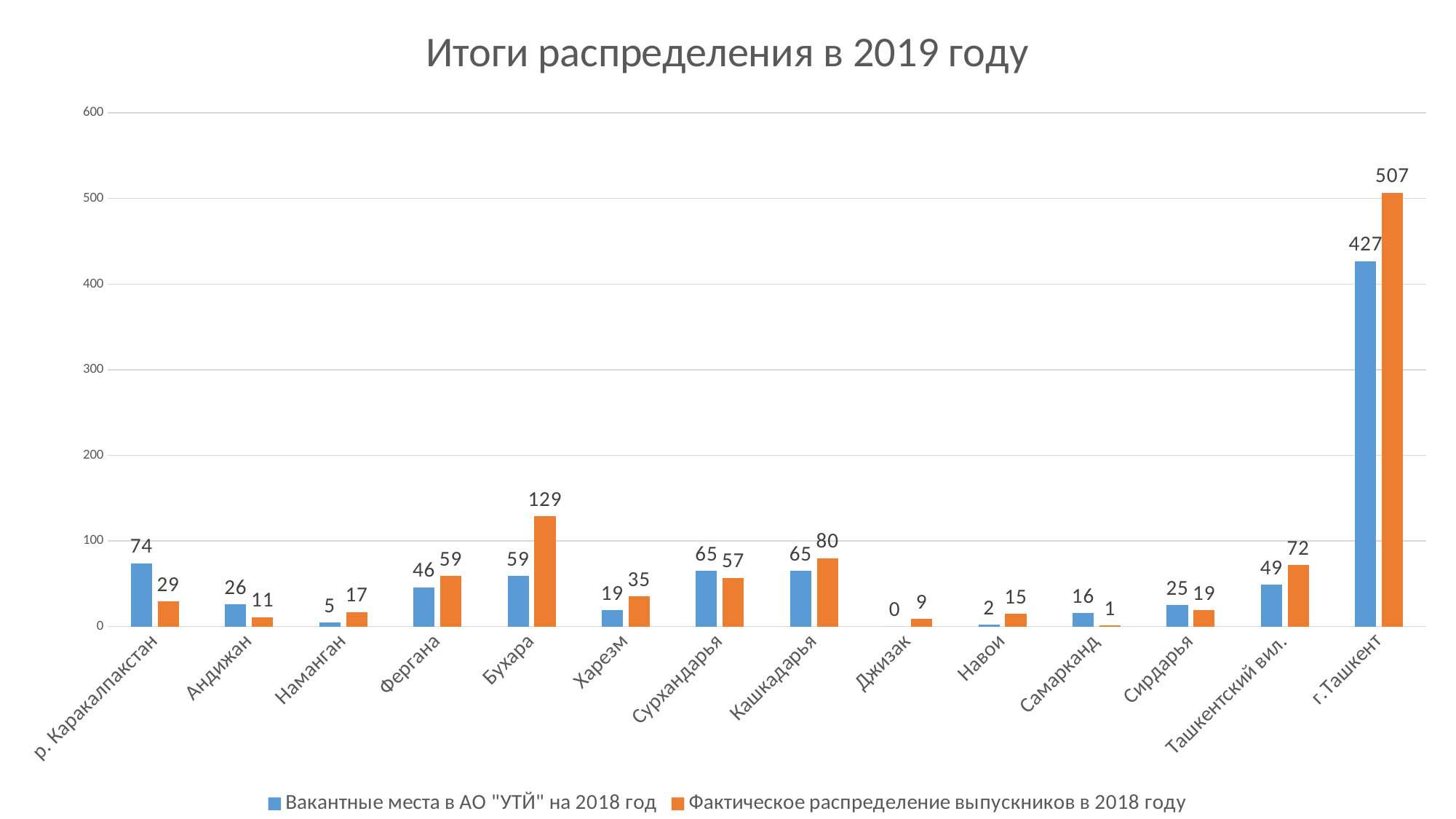
Which category has the highest value for "Фактическое распределение выпускников в 2018 году"? г.Ташкент What is the difference between the two series' values for г.Ташкент? 80 Is the value of "Вакантные места в АО "УТЙ" на 2018 год" for г.Ташкент greater or less than 400? greater How many series does the legend list? 2 Which category has the lowest value for "Вакантные места в АО "УТЙ" на 2018 год"? Джизак What is the value of "Вакантные места в АО "УТЙ" на 2018 год" for р. Каракалпакстан? 74 What is the value of "Фактическое распределение выпускников в 2018 году" for Бухара? 129 For Самарканд, which series has the larger value? Вакантные места в АО "УТЙ" на 2018 год What is the title of the chart? Итоги распределения в 2019 году What is the value of "Фактическое распределение выпускников в 2018 году" for Навои? 15 What kind of chart is shown on the slide? bar chart How many categories are shown on the x axis? 14